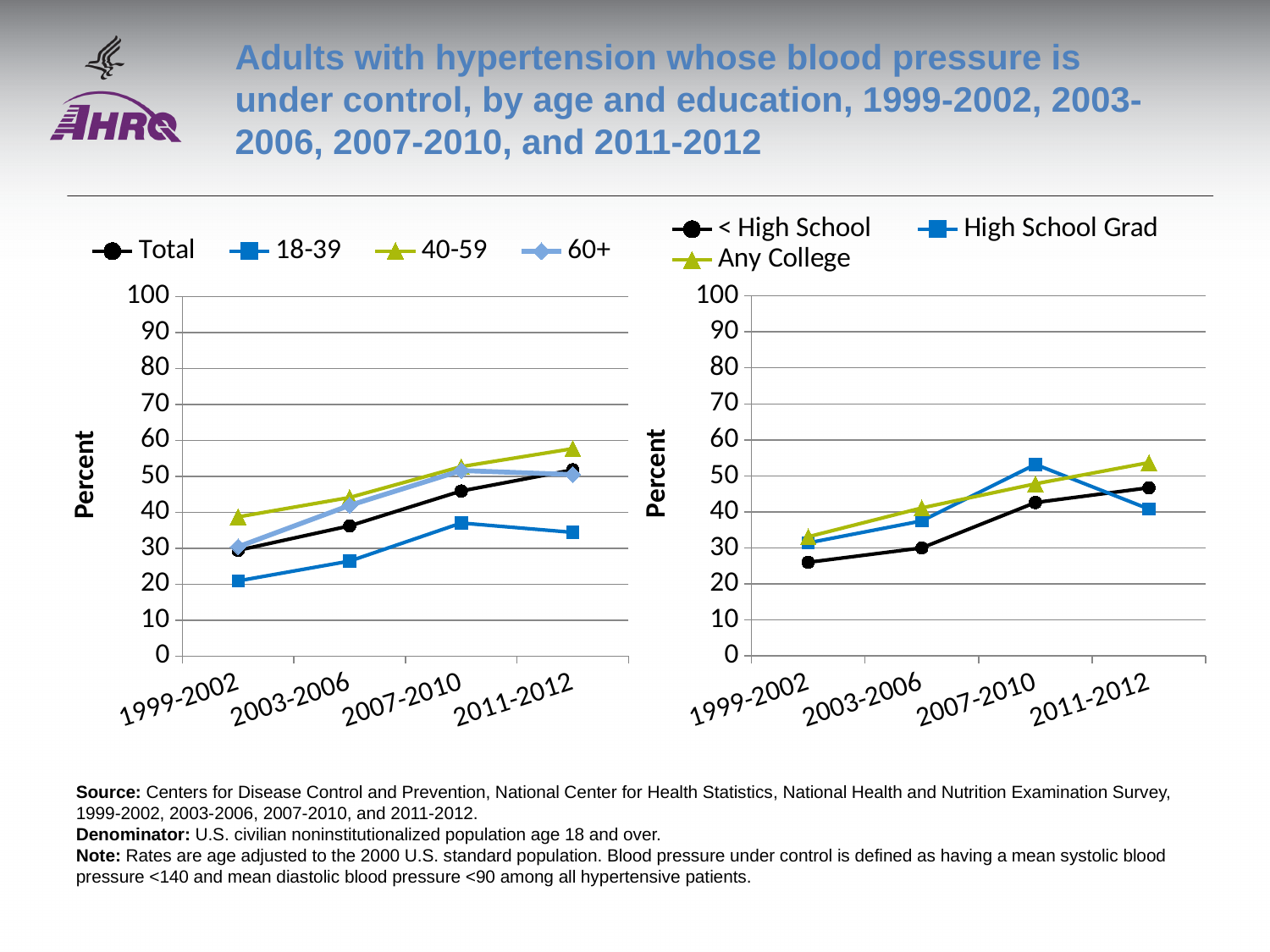
In the right chart (by education), is the value for < High School in 1999-2002 greater or less than 30? less In the left chart (by age), what kind of chart is shown? line chart In the left chart (by age), which age group has the highest value in 2011-2012? 40-59 In the left chart (by age), which age group has the lowest value in 2011-2012? 18-39 In the right chart (by education), which education group has the highest value in 2007-2010? High School Grad In the right chart (by education), how many series does the legend list? 3 In the left chart (by age), is the value for 18-39 in 1999-2002 greater or less than 30? less In the left chart (by age), how many time periods are shown on the x axis? 4 In the right chart (by education), which is larger in 2011-2012: Any College or High School Grad? Any College In the left chart (by age), how many series does the legend list? 4 In the left chart (by age), does the Total series rise or fall from 1999-2002 to 2011-2012? rise In the left chart (by age), is the value for 40-59 in 2011-2012 greater or less than 50? greater